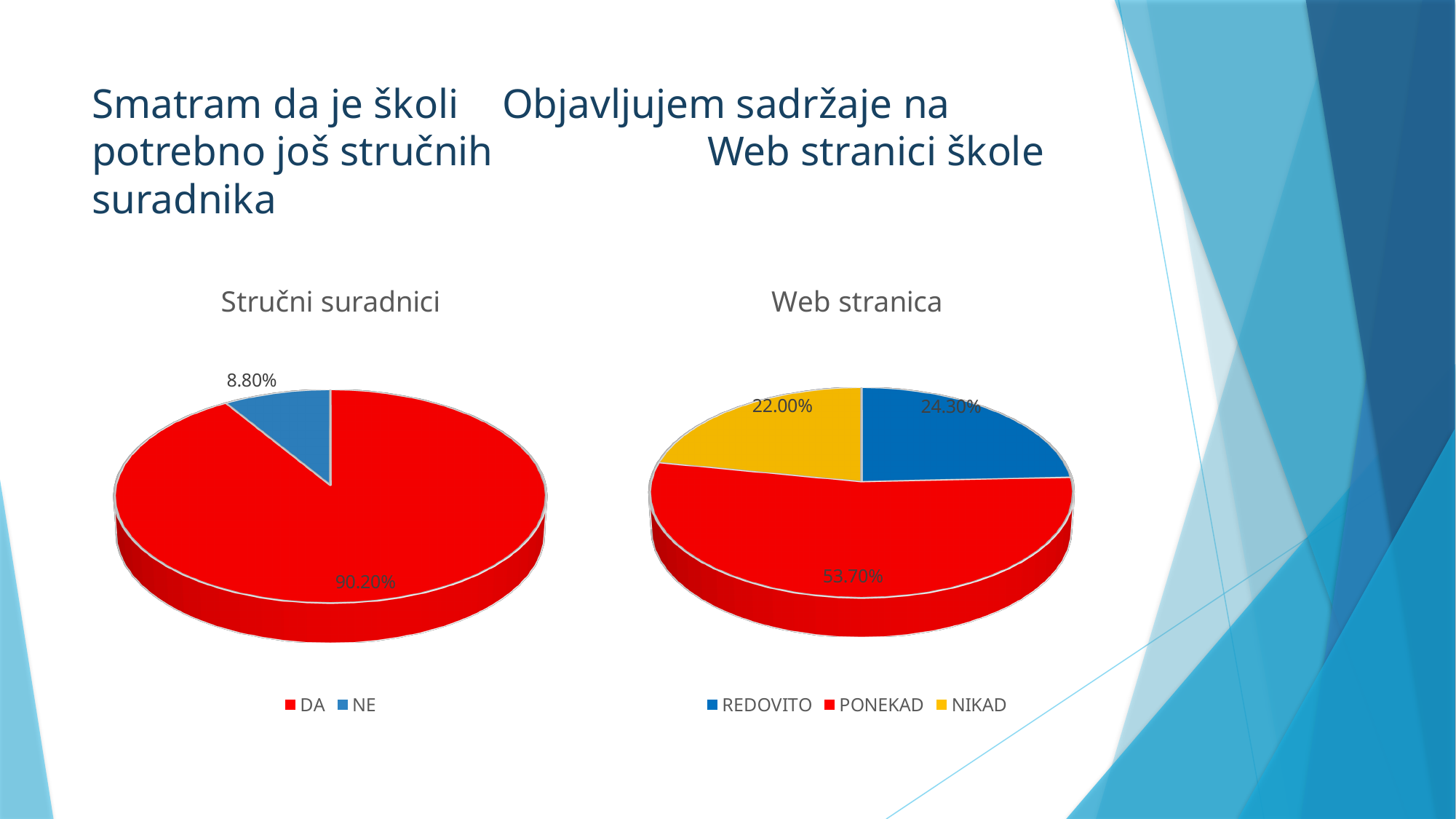
In the 'Web stranica' chart, which category has the smallest share? NIKAD In the 'Web stranica' chart, what is the value for NIKAD? 22.00% In the 'Stručni suradnici' chart, what is the value for NE? 8.80% How many categories does the legend of the 'Stručni suradnici' chart list? 2 In the 'Web stranica' chart, what colour is the PONEKAD slice? Red In the 'Stručni suradnici' chart, what is the value for DA? 90.20% In the 'Web stranica' chart, what is the value for REDOVITO? 24.30% In the 'Web stranica' chart, what is the value for PONEKAD? 53.70% In the 'Stručni suradnici' chart, which category has the largest share? DA In the 'Stručni suradnici' chart, what is the difference between DA and NE? 81.40% In the 'Web stranica' chart, which is larger, REDOVITO or NIKAD? REDOVITO What kind of chart is the 'Stručni suradnici' chart? Pie chart